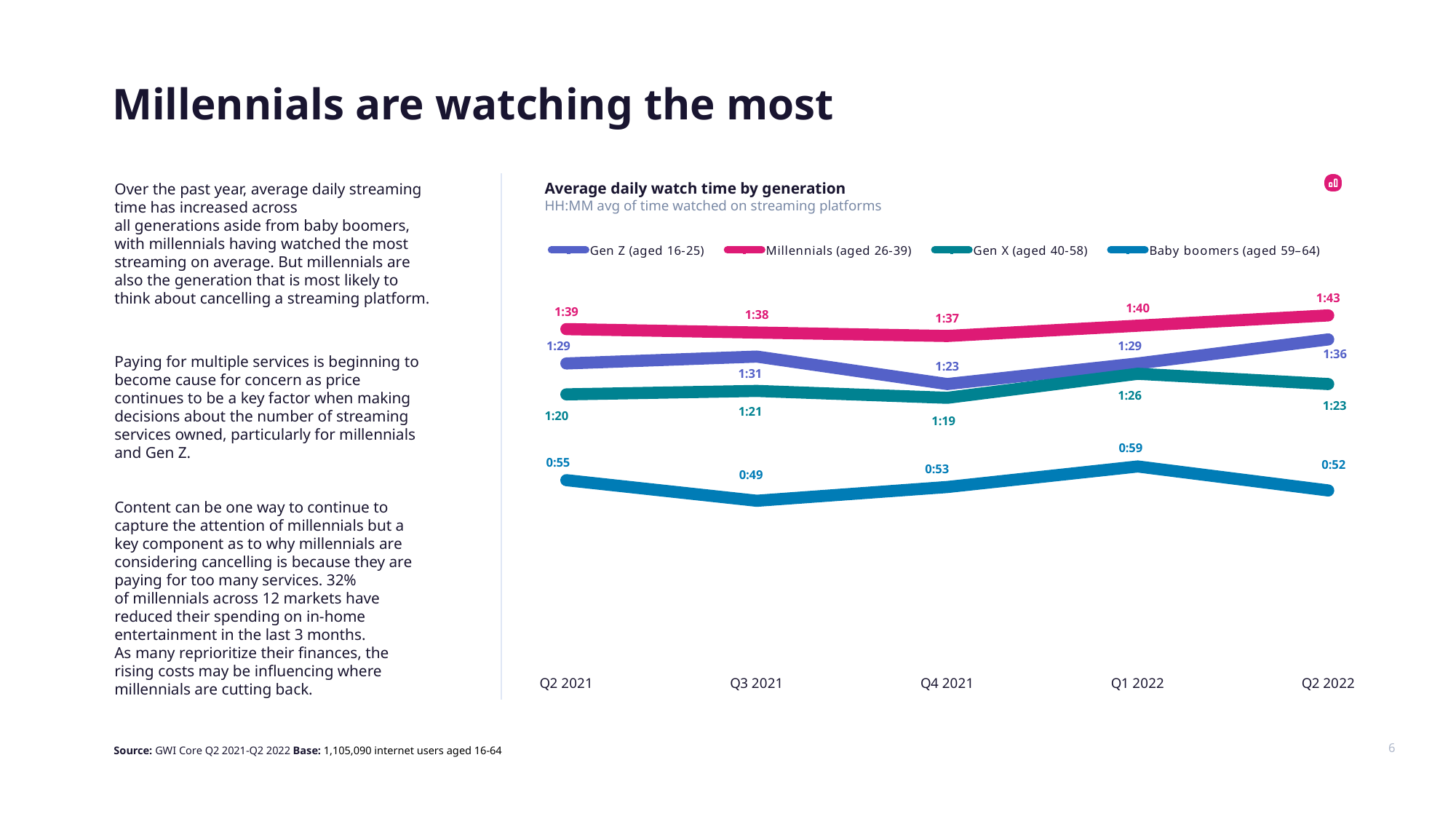
How many quarters are plotted along the x axis? 5 How many minutes more did Millennials (aged 26-39) watch than Gen Z (aged 16-25) in Q2 2022? 7 minutes What is the average daily watch time for Gen Z (aged 16-25) in Q4 2021? 1:23 Which generation has the lowest average daily watch time in Q1 2022? Baby boomers (aged 59–64) Which generation has the highest average daily watch time in Q2 2022? Millennials (aged 26-39) In which quarter did Baby boomers (aged 59–64) have their highest average daily watch time? Q1 2022 What type of chart is shown on the slide? Line chart Which is larger: Gen Z (aged 16-25) in Q3 2021 or Gen X (aged 40-58) in Q1 2022? Gen Z (aged 16-25) in Q3 2021 What is the average daily watch time for Gen X (aged 40-58) in Q1 2022? 1:26 What is the average daily watch time for Millennials (aged 26-39) in Q2 2022? 1:43 What is the average daily watch time for Baby boomers (aged 59–64) in Q3 2021? 0:49 How many series does the legend list? 4